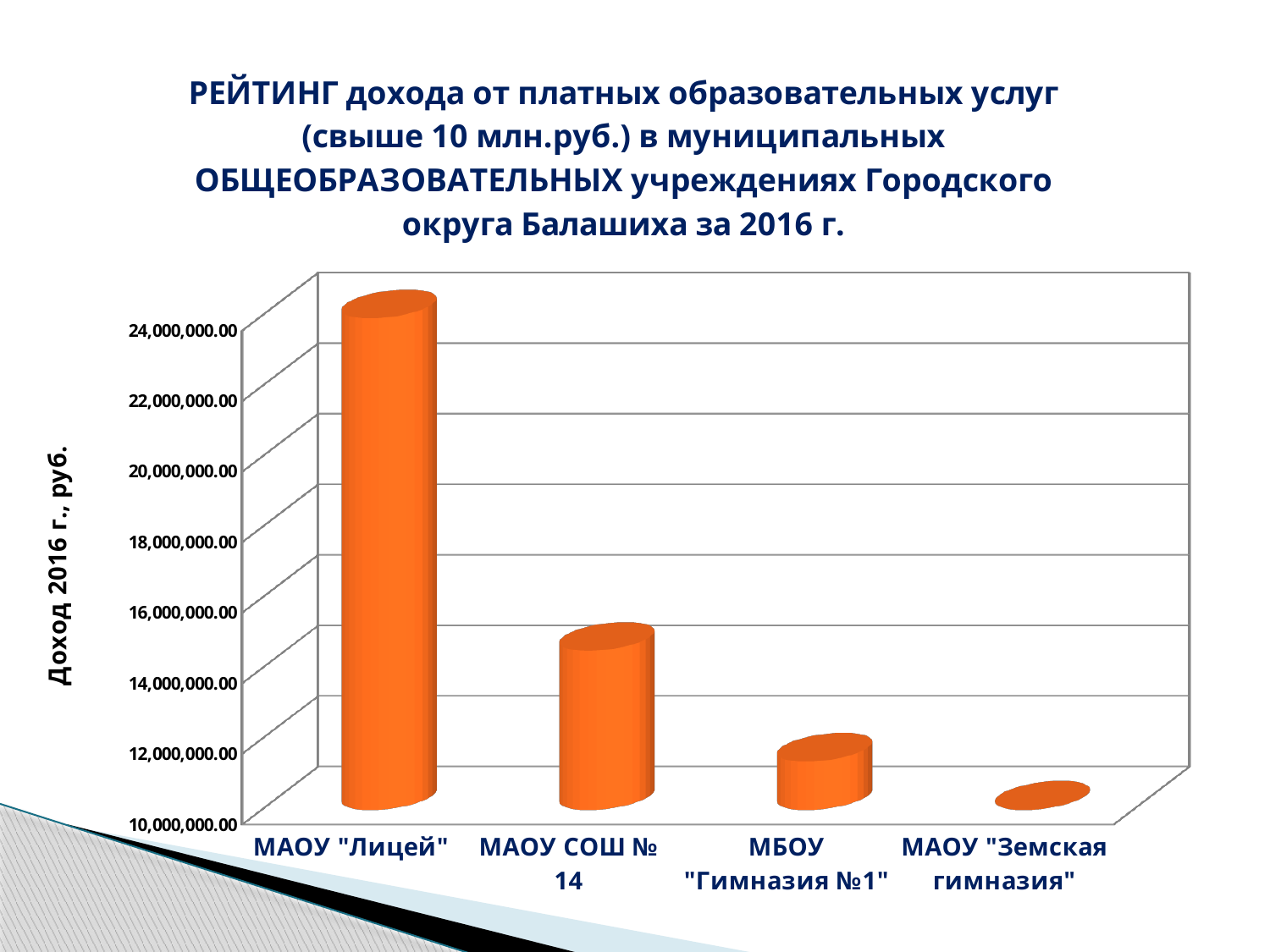
Is the value for МАОУ "Земская гимназия" greater or less than 12,000,000.00? less Which has the larger value: МАОУ "Лицей" or МАОУ СОШ № 14? МАОУ "Лицей" How many institutions (categories) are shown on the x axis of the chart? 4 Is the value for МБОУ "Гимназия №1" greater or less than 14,000,000.00? less Do the values rise or fall moving from left to right along the x axis? fall Is the value for МАОУ СОШ № 14 greater or less than 16,000,000.00? less Which has the larger value: МАОУ СОШ № 14 or МБОУ "Гимназия №1"? МАОУ СОШ № 14 Which institution has the highest income from paid educational services in the chart? МАОУ "Лицей" What kind of chart is shown on the slide? bar chart Which institution has the lowest income from paid educational services in the chart? МАОУ "Земская гимназия"